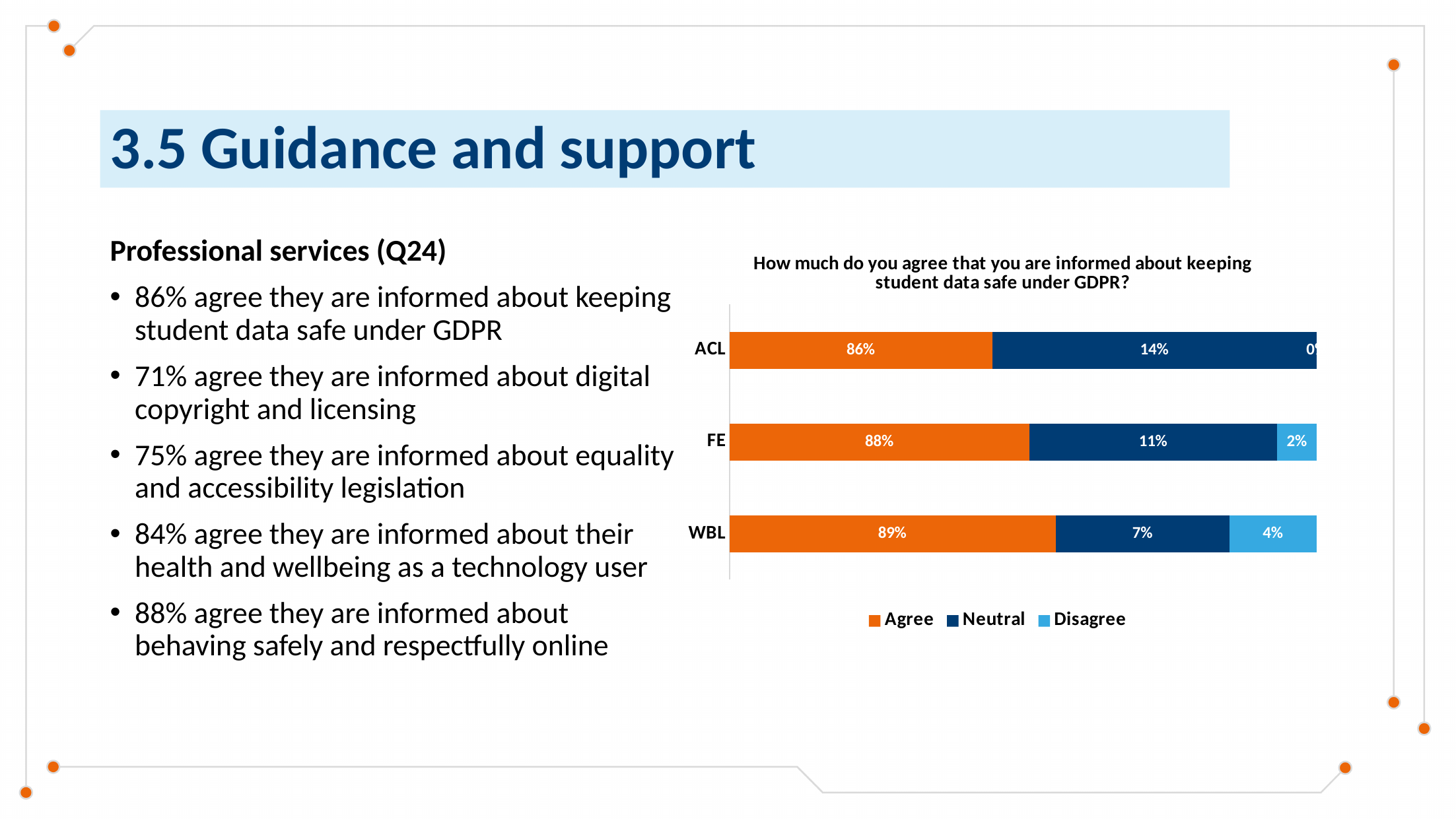
Which category has the lowest Neutral percentage? WBL What is the Disagree value for WBL in the chart? 4% Which colour represents the Agree series in the chart? Orange How many series does the chart legend list? 3 What type of chart is shown on the slide? Stacked bar chart Which category has the highest Agree percentage? WBL What is the Neutral value for FE in the chart? 11% How much higher is the Agree percentage for WBL than for ACL? 3% What is the title of the chart? How much do you agree that you are informed about keeping student data safe under GDPR? What percentage of ACL respondents agree that they are informed about keeping student data safe under GDPR? 86% Which has a larger Neutral percentage, ACL or FE? ACL How many categories are shown on the chart's vertical axis? 3